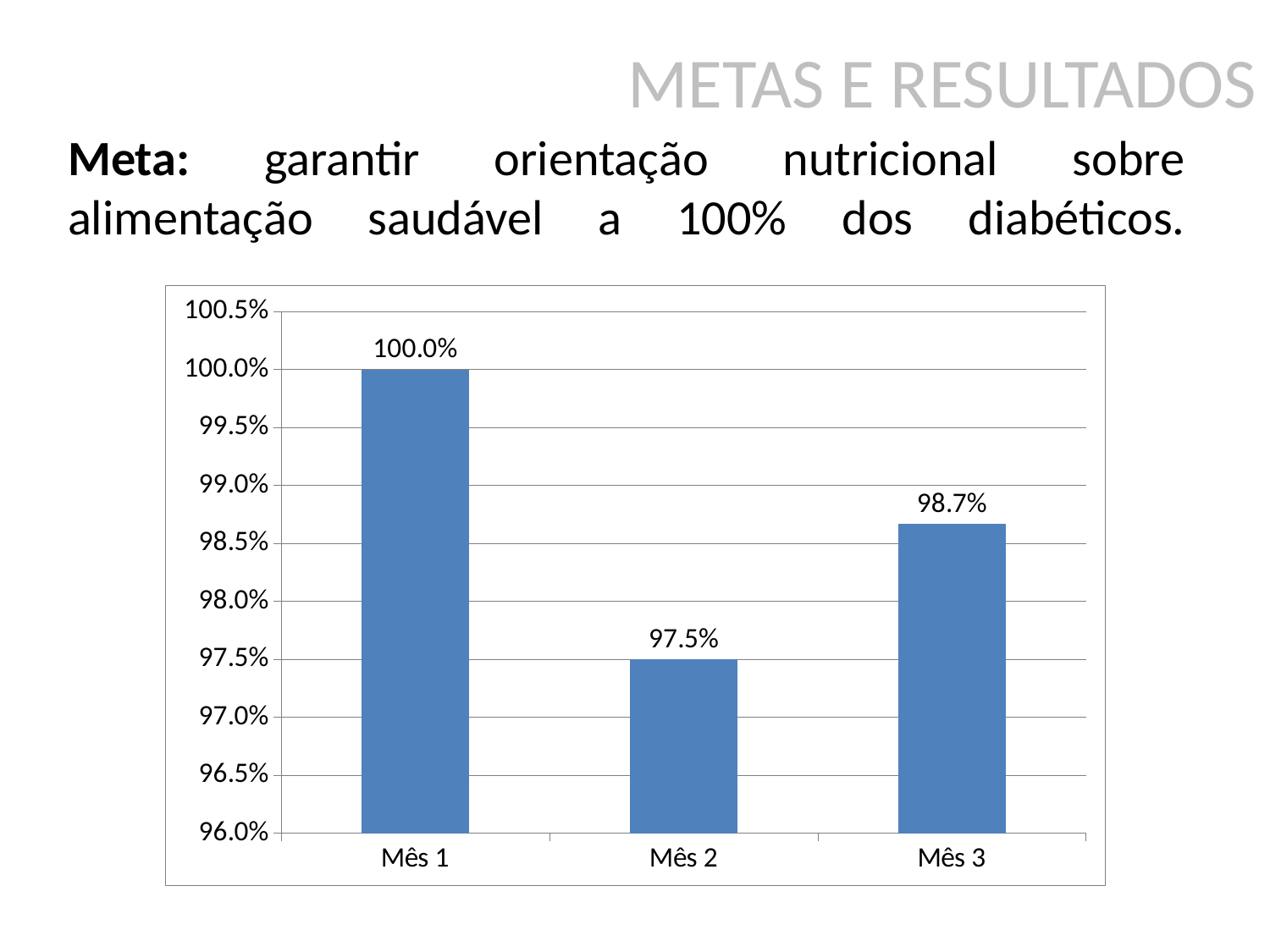
What kind of chart is shown on the slide? bar chart What is the value for Mês 3? 98.7% What is the value for Mês 1? 100.0% Which is larger, the value for Mês 2 or the value for Mês 3? Mês 3 What colour are the bars in the chart? blue What is the value for Mês 2? 97.5% What is the difference between the values for Mês 3 and Mês 2? 1.2% Is the value for Mês 3 greater or less than 99.0%? less What is the difference between the values for Mês 1 and Mês 2? 2.5% How many categories are shown on the x axis? 3 Which month has the lowest value? Mês 2 Which month has the highest value? Mês 1